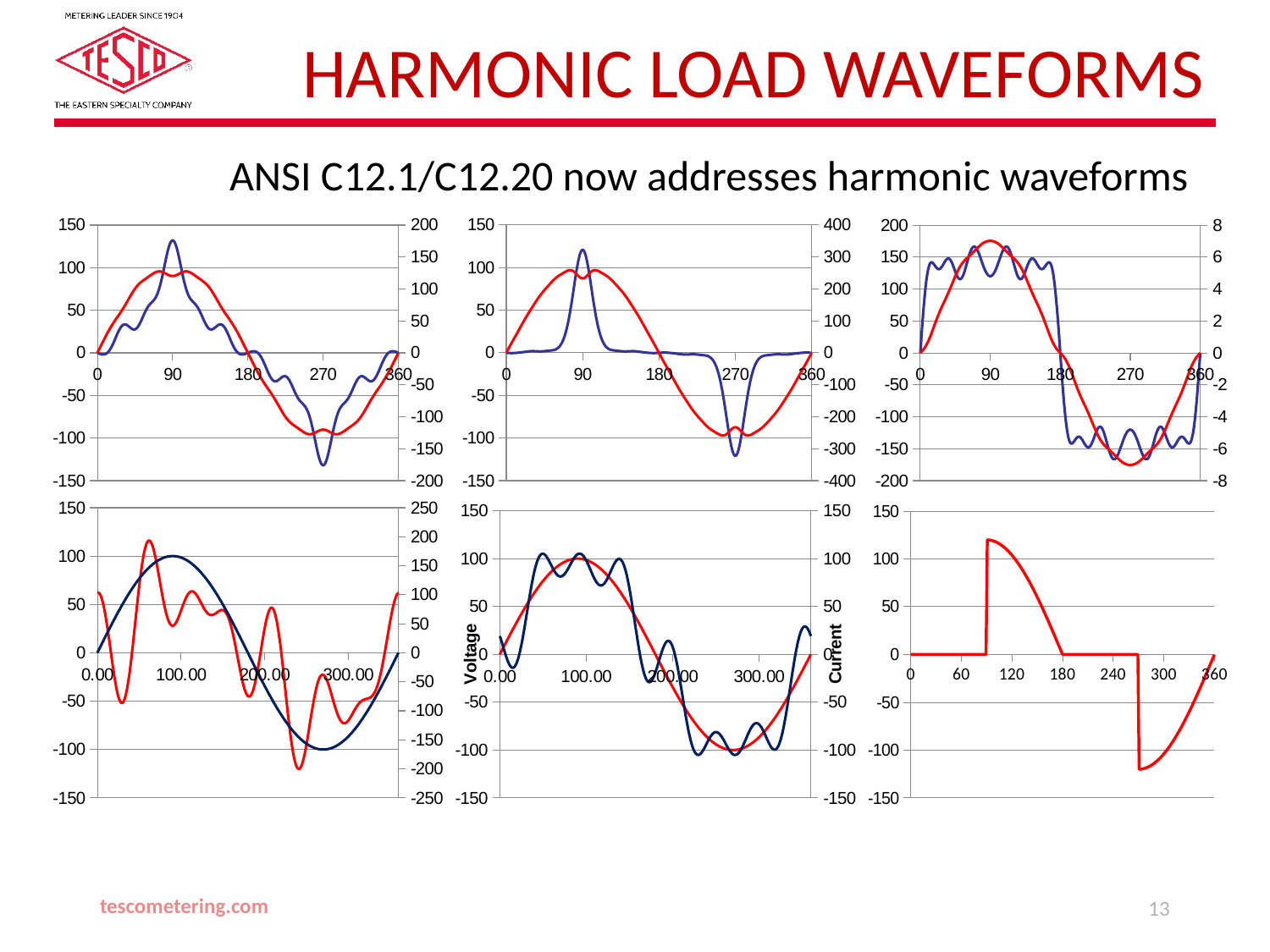
In the bottom-right chart, is the value of the line at x = 120 greater or less than 50? greater In the bottom-right chart, does the line rise or fall between x = 300 and x = 360? rise In the bottom-right chart, is the value of the line at x = 300 greater or less than 0? less In the bottom-right chart, what is the value of the line at x = 60? 0 What kind of chart is the bottom-right chart on the slide? line chart In the bottom-middle chart, what is the label on the left vertical axis? Voltage In the bottom-middle chart, what is the label on the right vertical axis? Current How many lines are plotted in the bottom-right chart? 1 In the bottom-right chart, does the line rise or fall between x = 120 and x = 180? fall How many charts are shown on the slide? 6